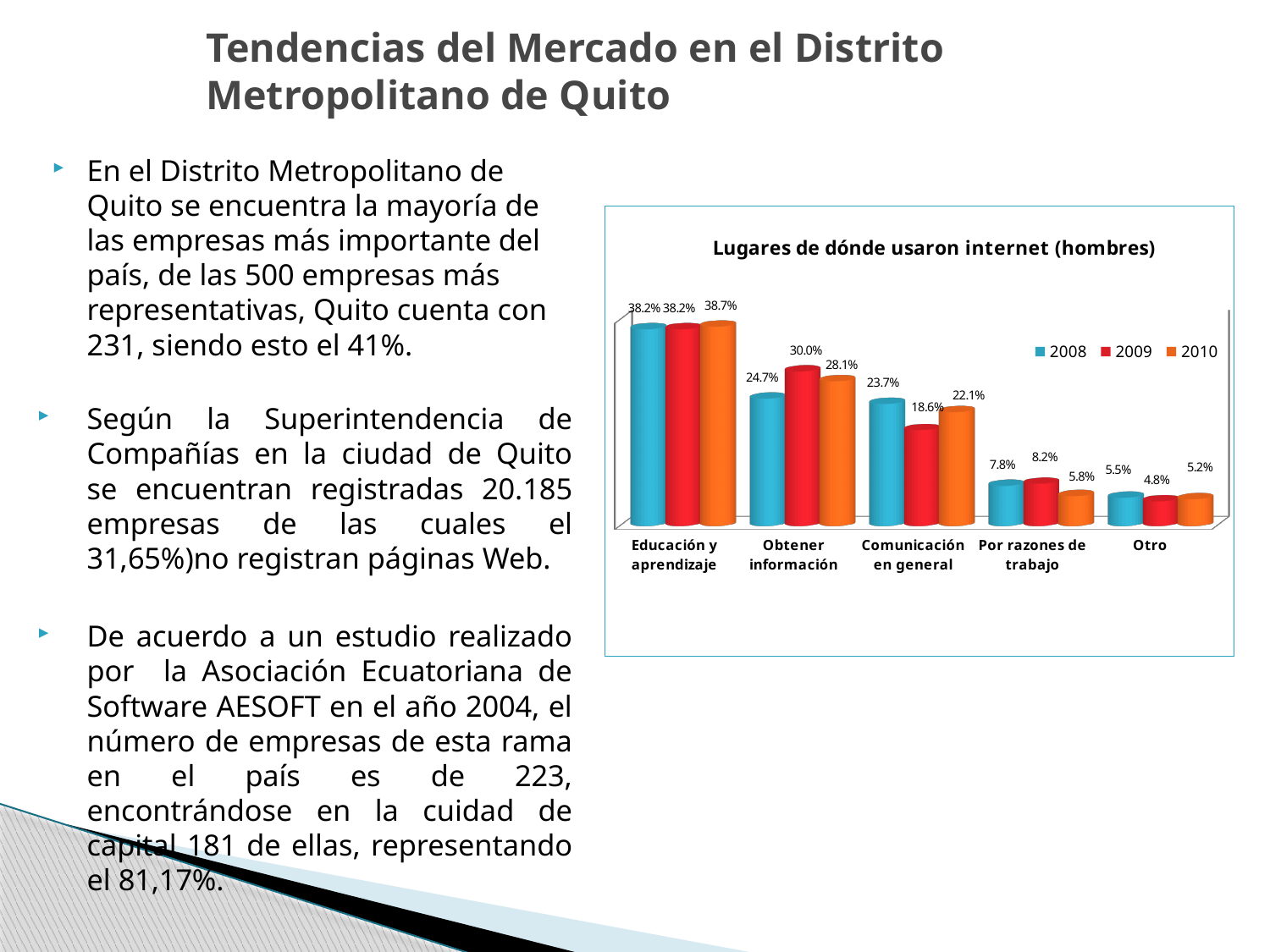
How many categories are shown on the x axis of the chart? 5 Which is larger in the 'Por razones de trabajo' category, the 2009 value or the 2010 value? 2009 What is the value for 2009 in the 'Obtener información' category? 30.0% Which category has the highest value for 2010? Educación y aprendizaje Which series is shown in orange in the chart's legend? 2010 What is the difference between the 2009 and 2008 values for 'Obtener información'? 5.3% What is the title of the chart on the slide? Lugares de dónde usaron internet (hombres) What is the value for 2008 in the 'Comunicación en general' category? 23.7% Which category has the lowest value for 2009? Otro How many series does the chart's legend list? 3 What is the value for 2010 in the 'Educación y aprendizaje' category? 38.7% What type of chart is shown on the slide? bar chart